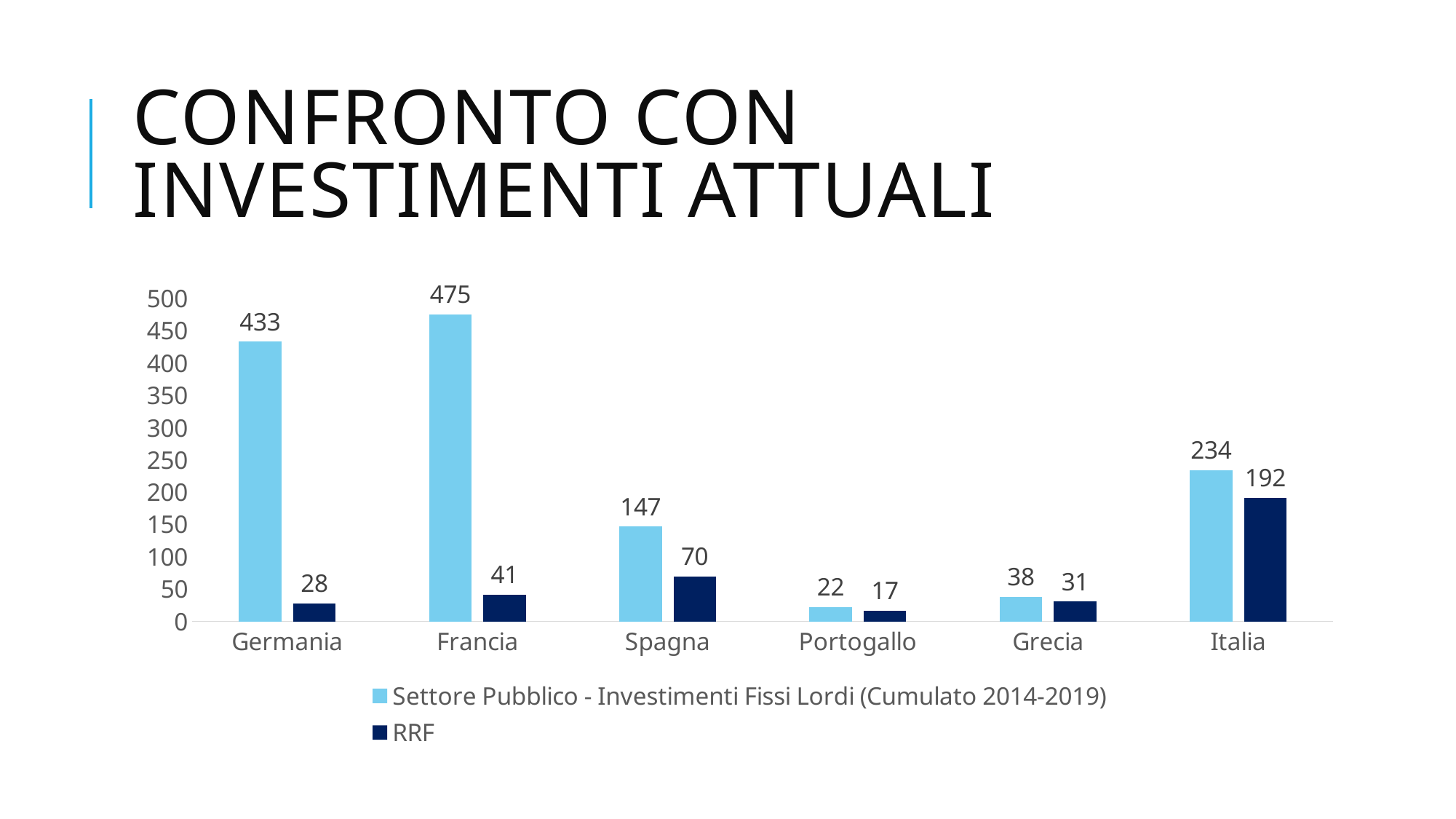
Which is larger for Spagna: the Settore Pubblico value or the RRF value? Settore Pubblico How many countries are shown on the x axis? 6 What kind of chart is shown on the slide? Bar chart Is the RRF value for Italia greater or less than 150? greater Which country has the lowest RRF value? Portogallo What is the value of Settore Pubblico - Investimenti Fissi Lordi (Cumulato 2014-2019) for Francia? 475 What colour are the RRF bars? Dark blue Which country has the highest value for Settore Pubblico - Investimenti Fissi Lordi (Cumulato 2014-2019)? Francia How many series does the legend list? 2 What is the RRF value for Portogallo? 17 What is the RRF value for Italia? 192 What is the difference between the Settore Pubblico value and the RRF value for Germania? 405